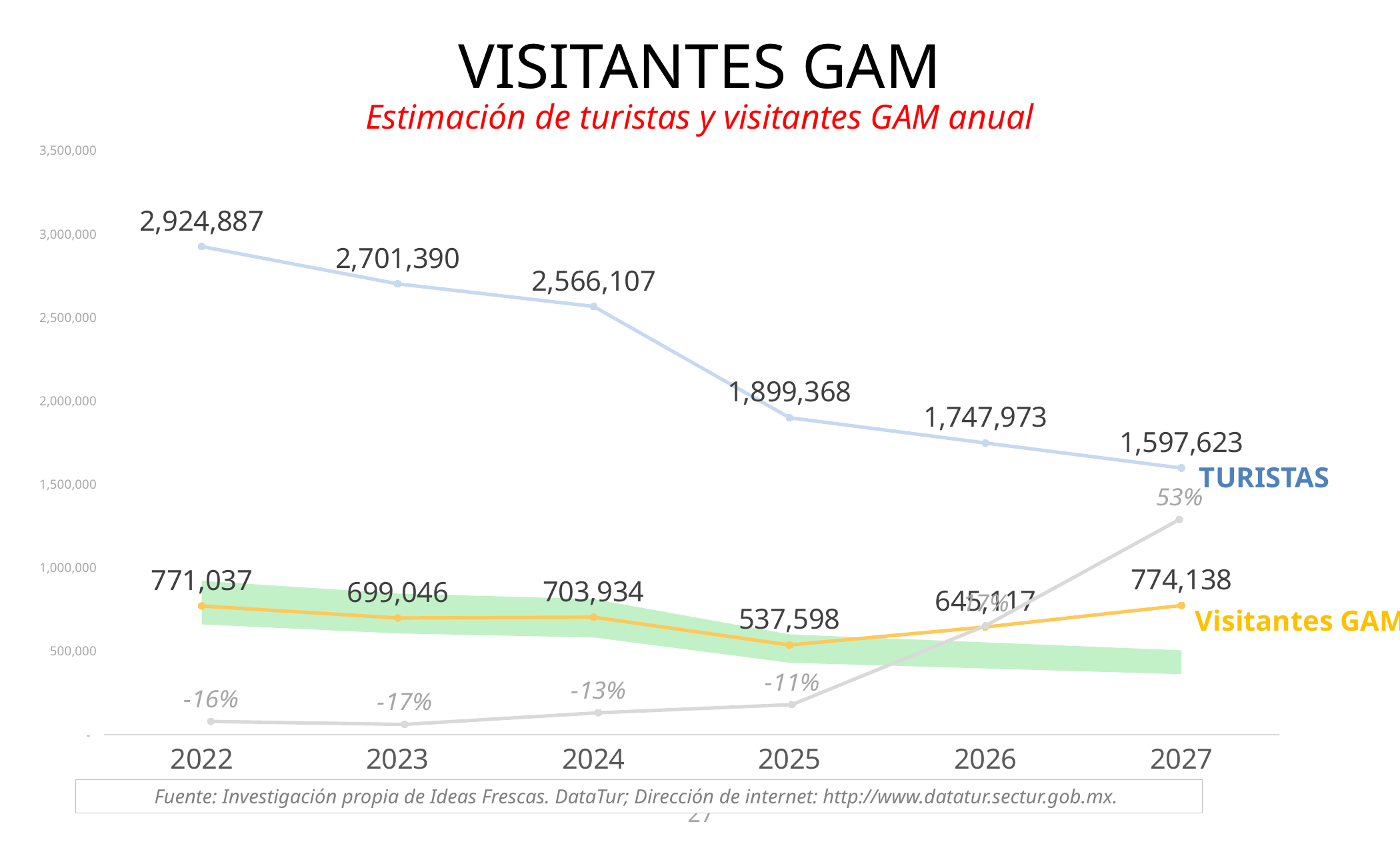
In which year is the TURISTAS value highest? 2022 What is the difference between the TURISTAS values for 2022 and 2027? 1,327,264 How many years are shown on the x axis? 6 What is the Visitantes GAM value for 2025? 537,598 Which is larger, the Visitantes GAM value for 2024 or for 2023? 2024 In which year is the TURISTAS value lowest? 2027 What is the Visitantes GAM value for 2023? 699,046 What kind of chart is shown on the slide? Line chart Does the TURISTAS line rise or fall from 2022 to 2027? Fall What is the TURISTAS value for 2027? 1,597,623 In which year is the Visitantes GAM value lowest? 2025 What is the TURISTAS value for 2022? 2,924,887